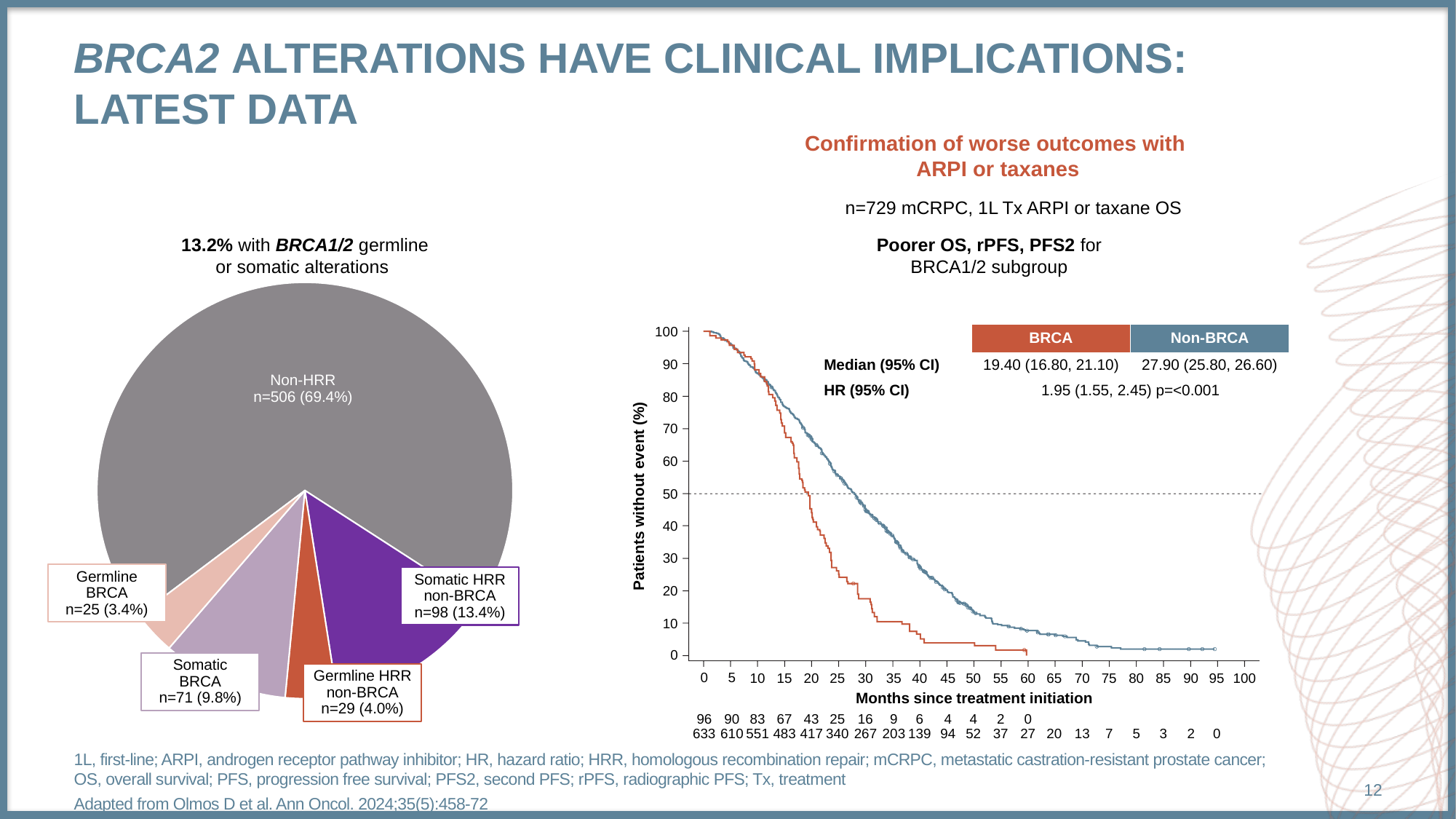
In the pie chart on the left, which slice is the smallest? Germline BRCA In the pie chart on the left, how many more patients are in the Somatic HRR non-BRCA slice than in the Germline HRR non-BRCA slice? 69 In the pie chart on the left, how many patients are in the Non-HRR slice? n=506 (69.4%) In the survival curve chart on the right, what is the HR (95% CI)? 1.95 (1.55, 2.45) p=<0.001 In the pie chart on the left, how many slices are there? 5 What kind of chart is the chart on the left of the slide? Pie chart In the survival curve chart on the right, what is the label of the y axis? Patients without event (%) In the survival curve chart on the right, how many groups are plotted? 2 In the survival curve chart on the right, what is the median (95% CI) for the BRCA group? 19.40 (16.80, 21.10) In the pie chart on the left, what percentage of patients have Somatic BRCA alterations? 9.8% In the pie chart on the left, which slice is larger: Somatic BRCA or Germline BRCA? Somatic BRCA